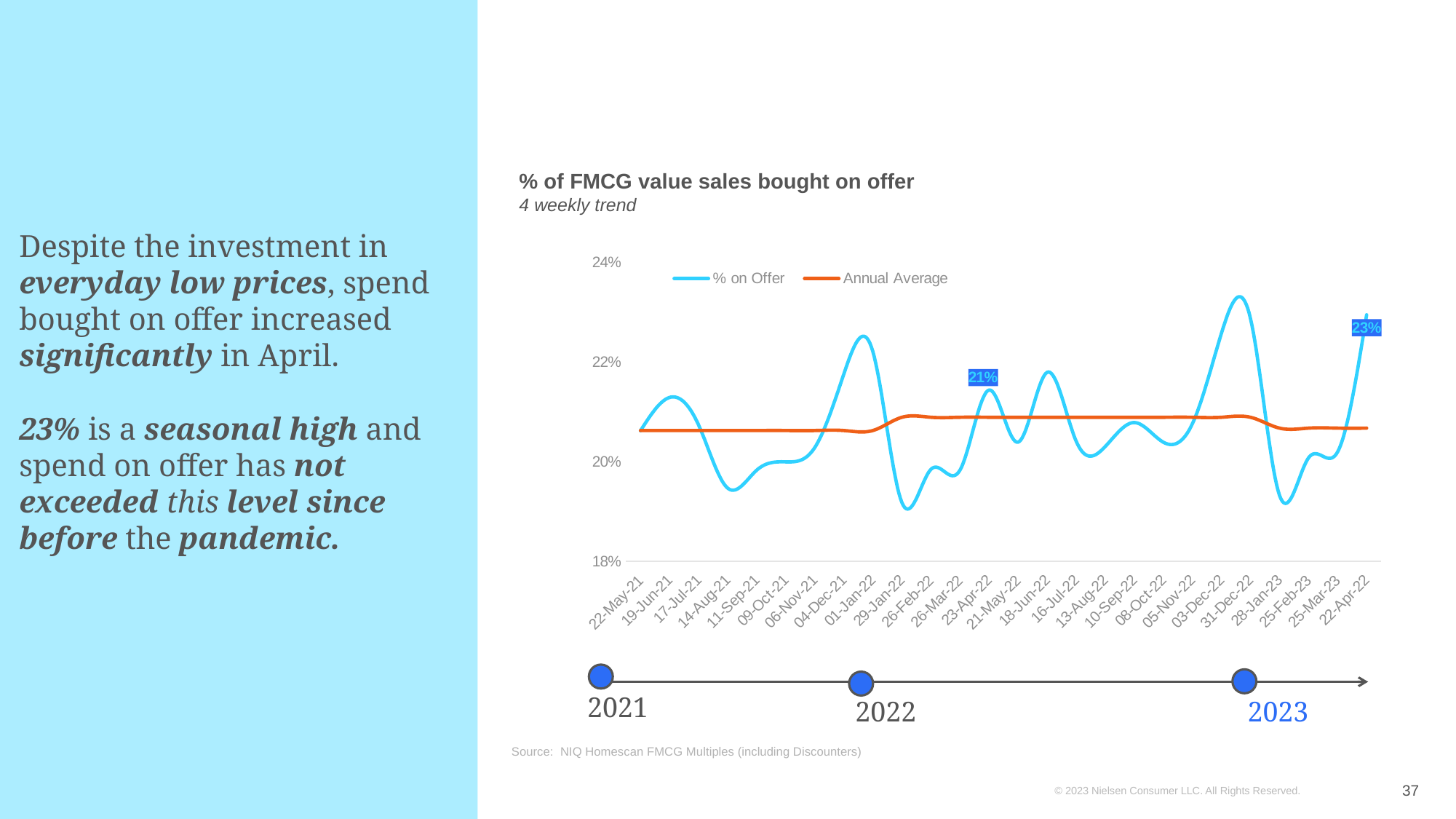
Is the % on Offer value at 03-Dec-22 greater or less than 22%? greater How many date labels are shown on the x axis of the chart? 26 What is the title of the chart? % of FMCG value sales bought on offer What value is labelled for % on Offer at the final data point on the right of the chart? 23% Is the % on Offer value at 29-Jan-22 greater or less than 20%? less What type of chart is shown on the slide? Line chart What is the difference between the two labelled % on Offer values, 23% and 21%? 2 percentage points How many series does the chart legend list? 2 Is the Annual Average line greater or less than 22% throughout the chart? less Which is larger: the % on Offer value at 01-Jan-22 or at 29-Jan-22? 01-Jan-22 What are the two series named in the chart legend? % on Offer and Annual Average What value is labelled for % on Offer at 23-Apr-22? 21%